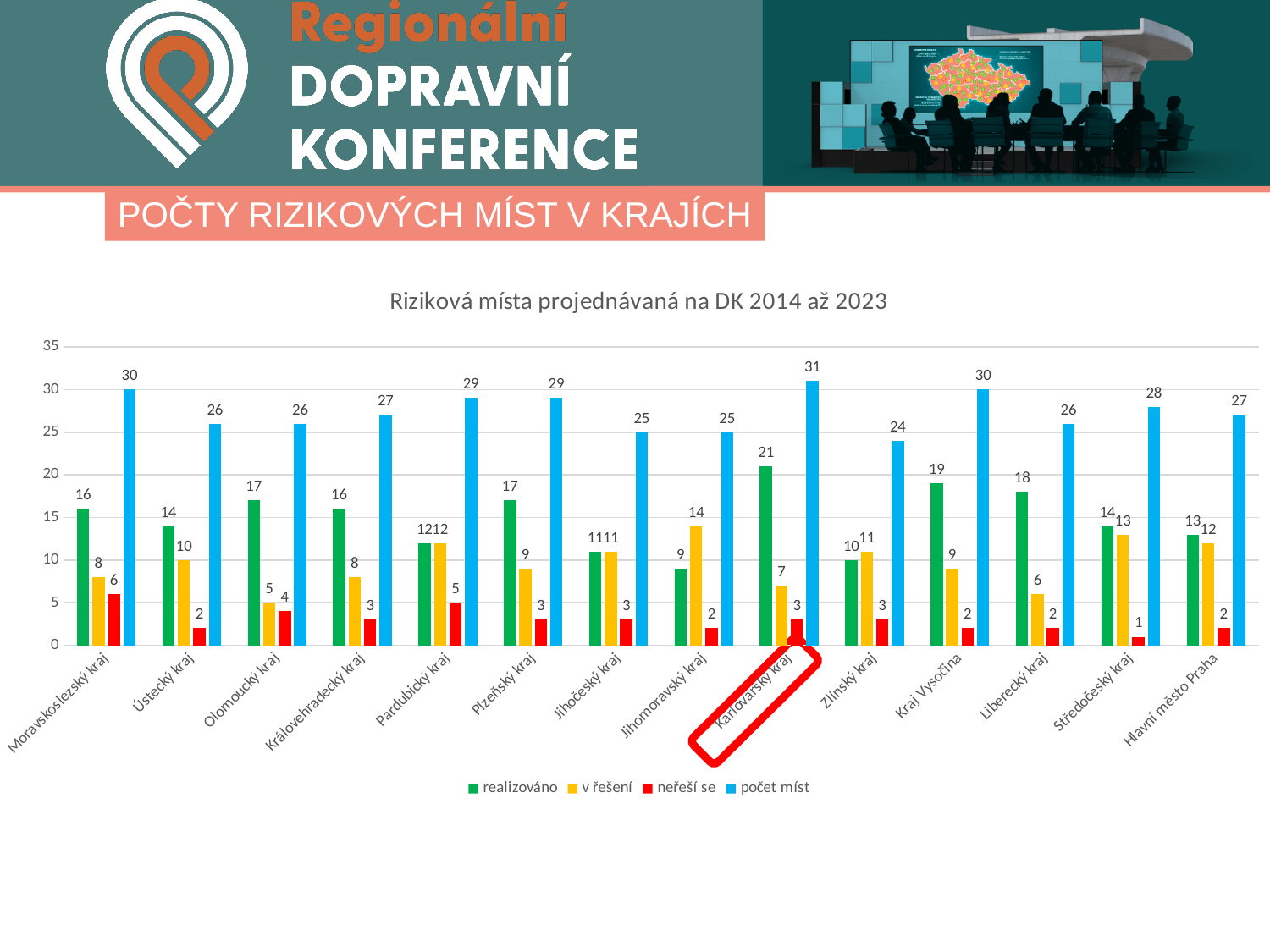
How many series does the legend list? 4 Which region has the highest 'počet míst' value? Karlovarský kraj What is the difference between 'počet míst' and 'realizováno' for Karlovarský kraj? 10 What type of chart is shown on the slide? bar chart Which region has the lowest 'neřeší se' value? Středočeský kraj Which colour represents the 'neřeší se' series? red What is the 'v řešení' value for Jihomoravský kraj? 14 Which is larger for Moravskoslezský kraj: 'realizováno' or 'v řešení'? realizováno What is the title of the chart? Riziková místa projednávaná na DK 2014 až 2023 What is the 'realizováno' value for Kraj Vysočina? 19 What is the value of 'počet míst' for Karlovarský kraj? 31 How many regions (categories) are shown on the x axis? 14